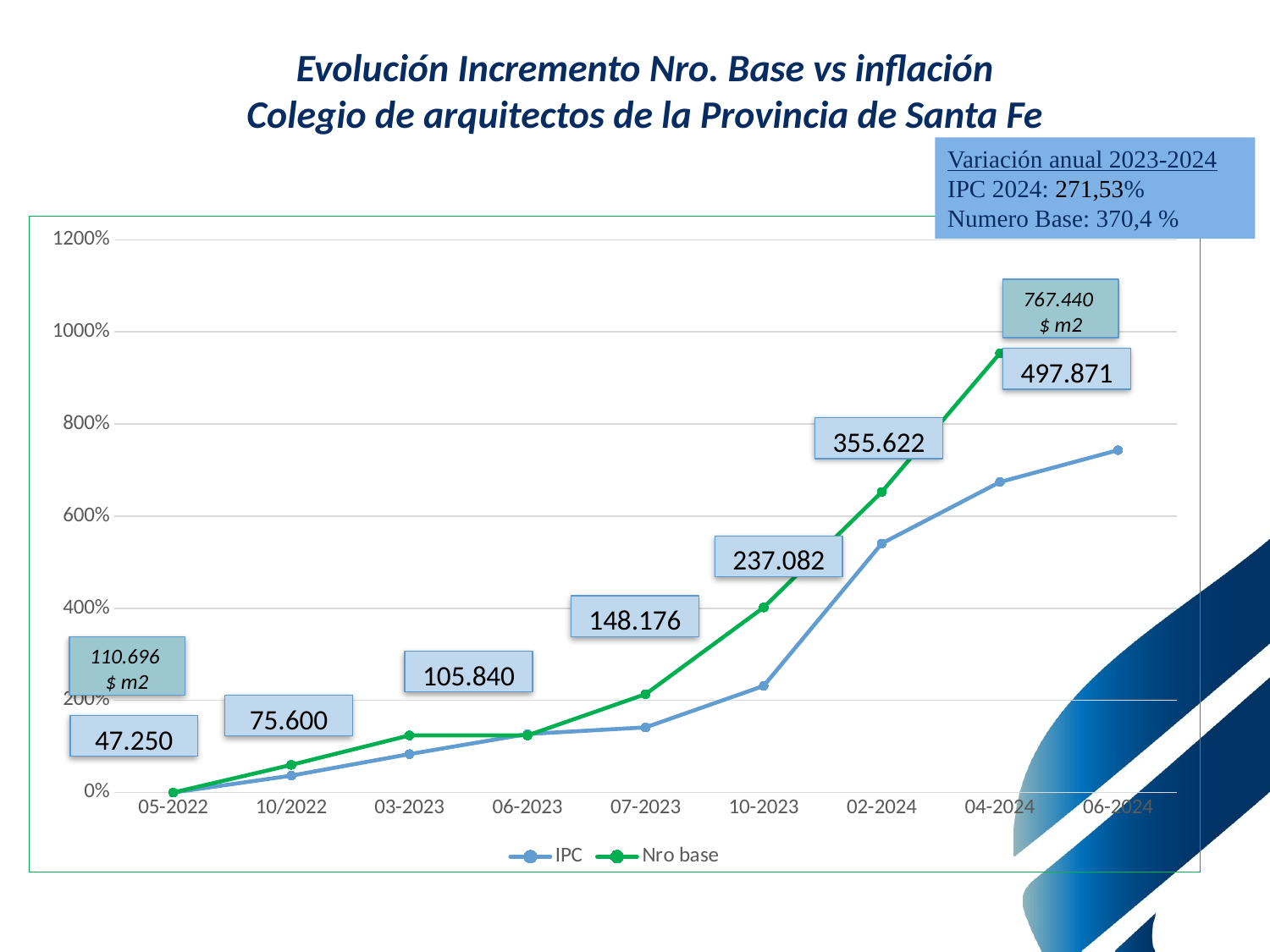
At 10-2023, which series has the higher value, IPC or Nro base? Nro base What are the two series named in the legend? IPC and Nro base Is the value for Nro base at 04-2024 greater or less than 800%? greater At 02-2024, which series has the higher value, IPC or Nro base? Nro base Is the value for IPC at 10-2023 greater or less than 400%? less Do the IPC values rise or fall from 05-2022 to 06-2024? rise What kind of chart is shown on the slide? line chart How many dates are shown on the x axis? 9 How many series does the legend list? 2 Is the value for Nro base at 10-2023 greater or less than 200%? greater Which series reaches the highest value on the chart? Nro base